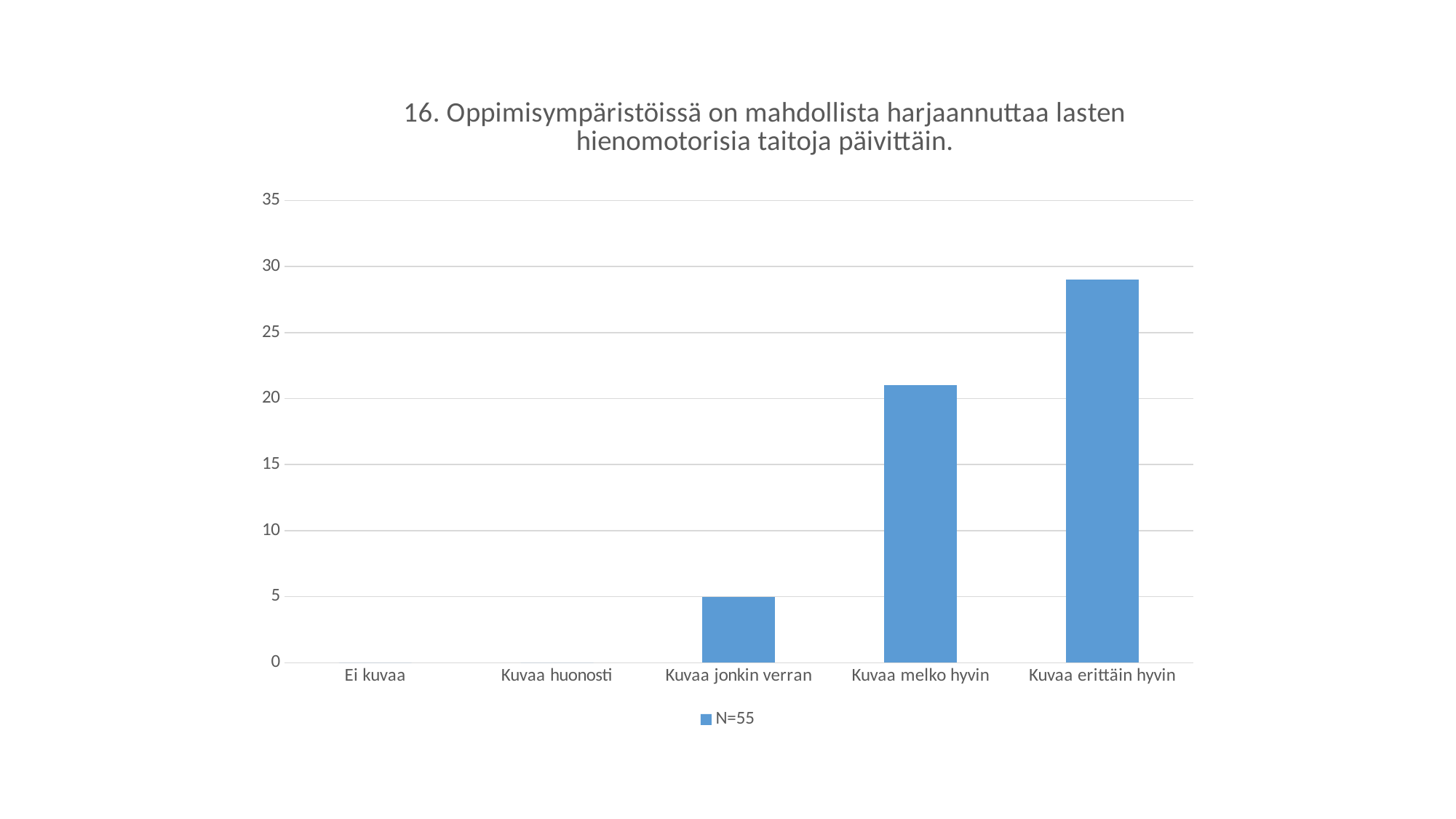
What kind of chart is shown on the slide? bar chart Is the value for "Kuvaa melko hyvin" greater or less than 25? less Is the value for "Kuvaa melko hyvin" greater or less than 20? greater What is the value for "Ei kuvaa"? 0 What is the value for "Kuvaa jonkin verran"? 5 What is the legend entry shown below the chart? N=55 Which is larger, the value for "Kuvaa melko hyvin" or the value for "Kuvaa jonkin verran"? Kuvaa melko hyvin Is the value for "Kuvaa erittäin hyvin" greater or less than 30? less How many categories are shown on the x axis of the chart? 5 Do the values rise or fall from left to right along the x axis? rise How many series does the chart's legend list? 1 Which category has the highest value? Kuvaa erittäin hyvin